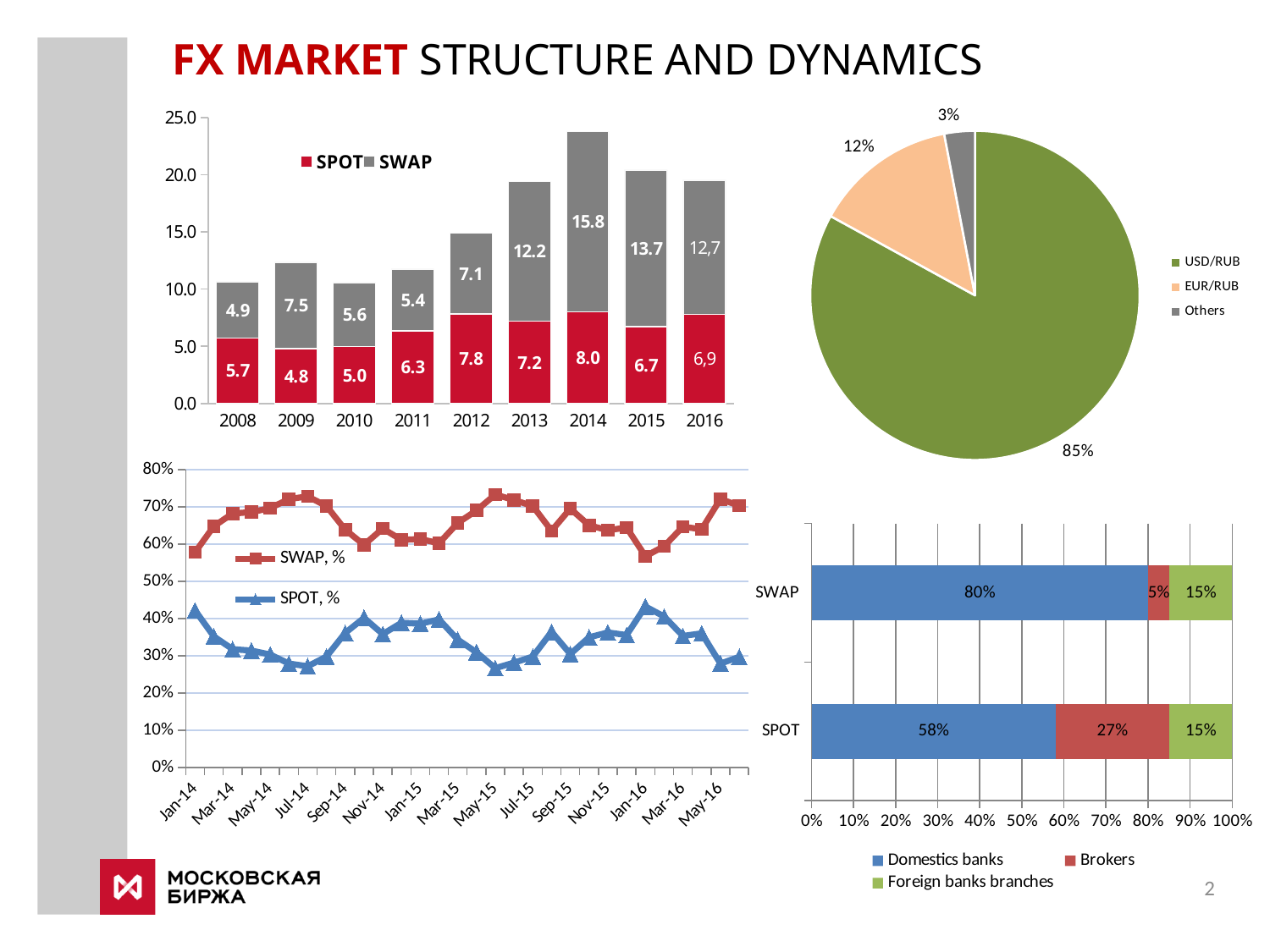
How many years are shown on the x axis of the top-left stacked bar chart? 9 In the top-left stacked bar chart, which year has the lowest SPOT value? 2009 In the top-left stacked bar chart, which year has the highest SWAP value? 2014 How many series does the legend of the bottom-left line chart list? 2 In the bottom-right horizontal bar chart, what is the Brokers share for SPOT? 27% In the pie chart at the top right, what share does USD/RUB have? 85% In the top-left stacked bar chart, what is the SPOT value for 2014? 8.0 In the top-left stacked bar chart, what is the difference between the SWAP values for 2014 and 2013? 3.6 In the top-left stacked bar chart, what is the SWAP value for 2008? 4.9 In the bottom-right horizontal bar chart, what is the Domestic banks share for SWAP? 80% In the pie chart at the top right, which category has the smallest slice? Others In the top-left stacked bar chart, what is the total of the SPOT and SWAP values for 2014? 23.8